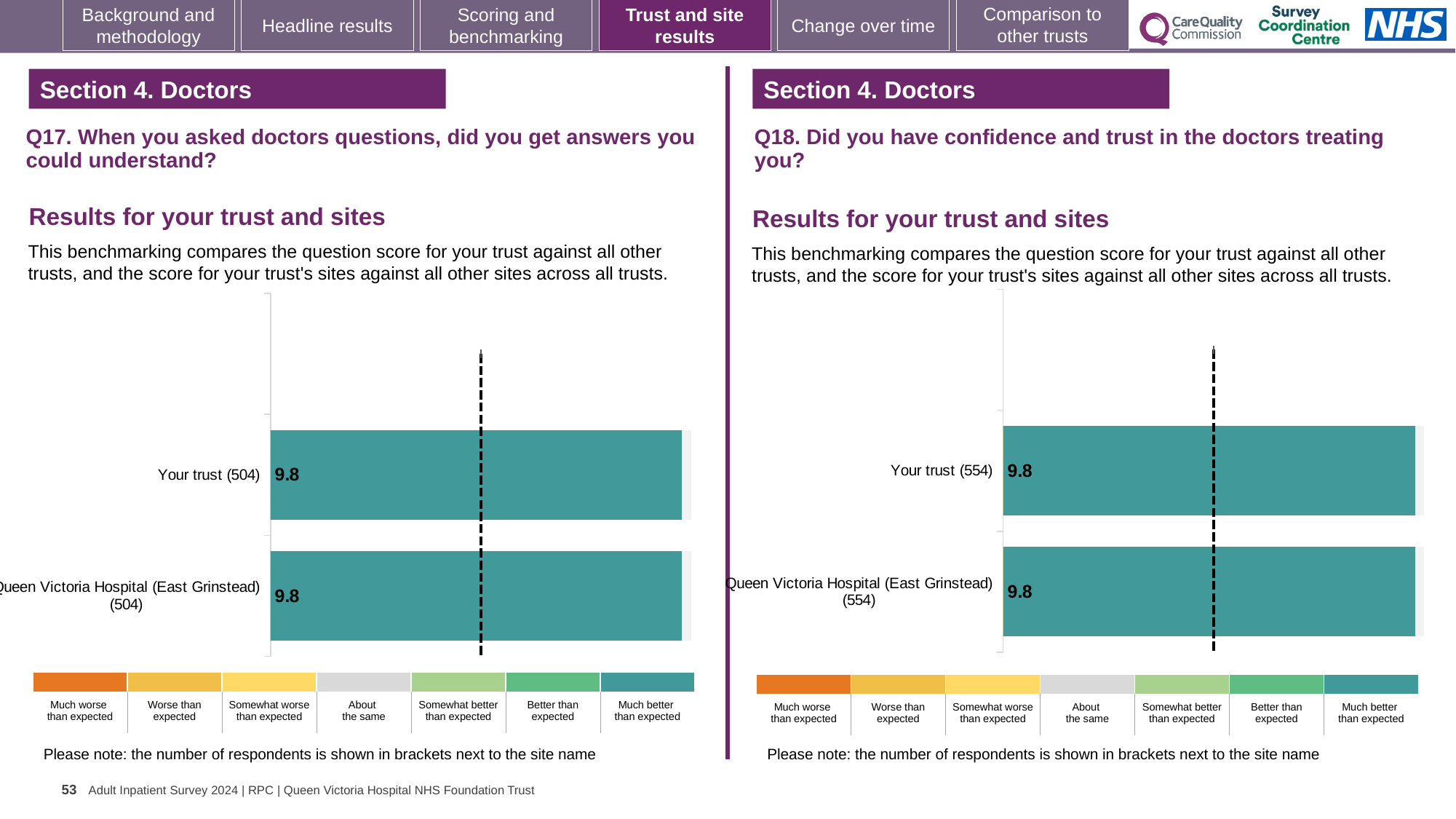
What type of chart is used for the Q17 results on the left? Bar chart In the Q17 chart on the left, what is the score for Your trust? 9.8 In the Q17 chart on the left, how many respondents are shown in brackets next to Your trust? 504 How many charts are shown on the slide? 2 In the Q17 chart on the left, what is the difference between the score for Your trust and the score for Queen Victoria Hospital (East Grinstead)? 0 In the Q18 chart on the right, what is the difference between the score for Your trust and the score for Queen Victoria Hospital (East Grinstead)? 0 In the Q18 chart on the right, how many respondents are shown in brackets next to Queen Victoria Hospital (East Grinstead)? 554 How many bars are plotted in the Q18 chart on the right? 2 In the Q18 chart on the right, what is the score for Your trust? 9.8 In the Q18 chart on the right, what is the score for Queen Victoria Hospital (East Grinstead)? 9.8 In the Q17 chart on the left, what is the score for Queen Victoria Hospital (East Grinstead)? 9.8 How many bars are plotted in the Q17 chart on the left? 2